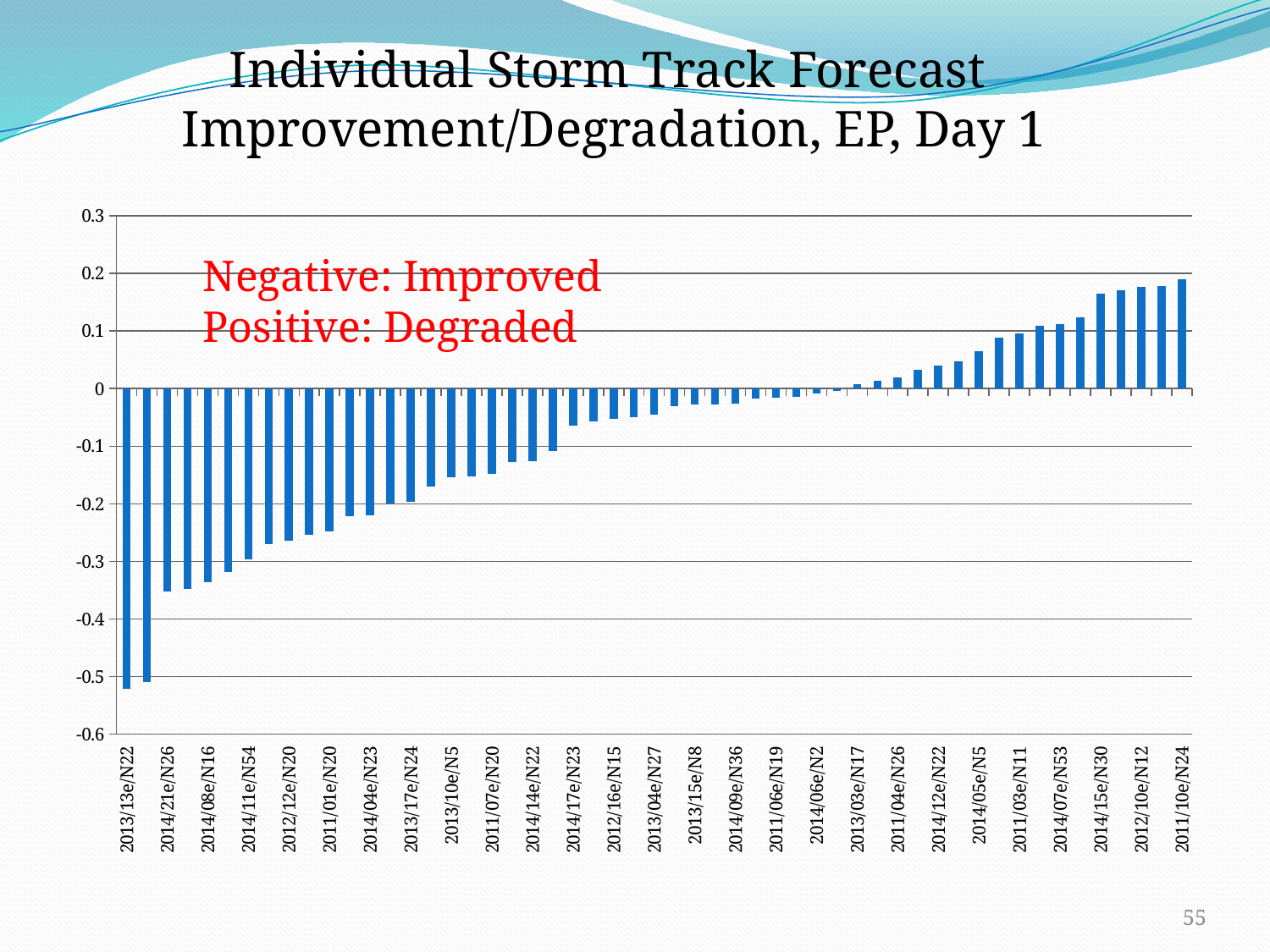
Which has the larger value, 2014/15e/N30 or 2011/03e/N11? 2014/15e/N30 Which storm has the lowest (most negative) value? 2013/13e/N22 Which storm has the highest value? 2011/10e/N24 What kind of chart is shown on the slide? bar chart What is the title of the chart? Individual Storm Track Forecast Improvement/Degradation, EP, Day 1 Is the value for 2014/12e/N22 greater or less than 0.1? less Is the value for 2012/12e/N20 greater or less than -0.3? greater Do the values rise or fall moving from left to right along the x axis? rise Is the value for 2013/13e/N22 greater or less than -0.4? less According to the red annotation on the chart, what does a negative value indicate? Improved